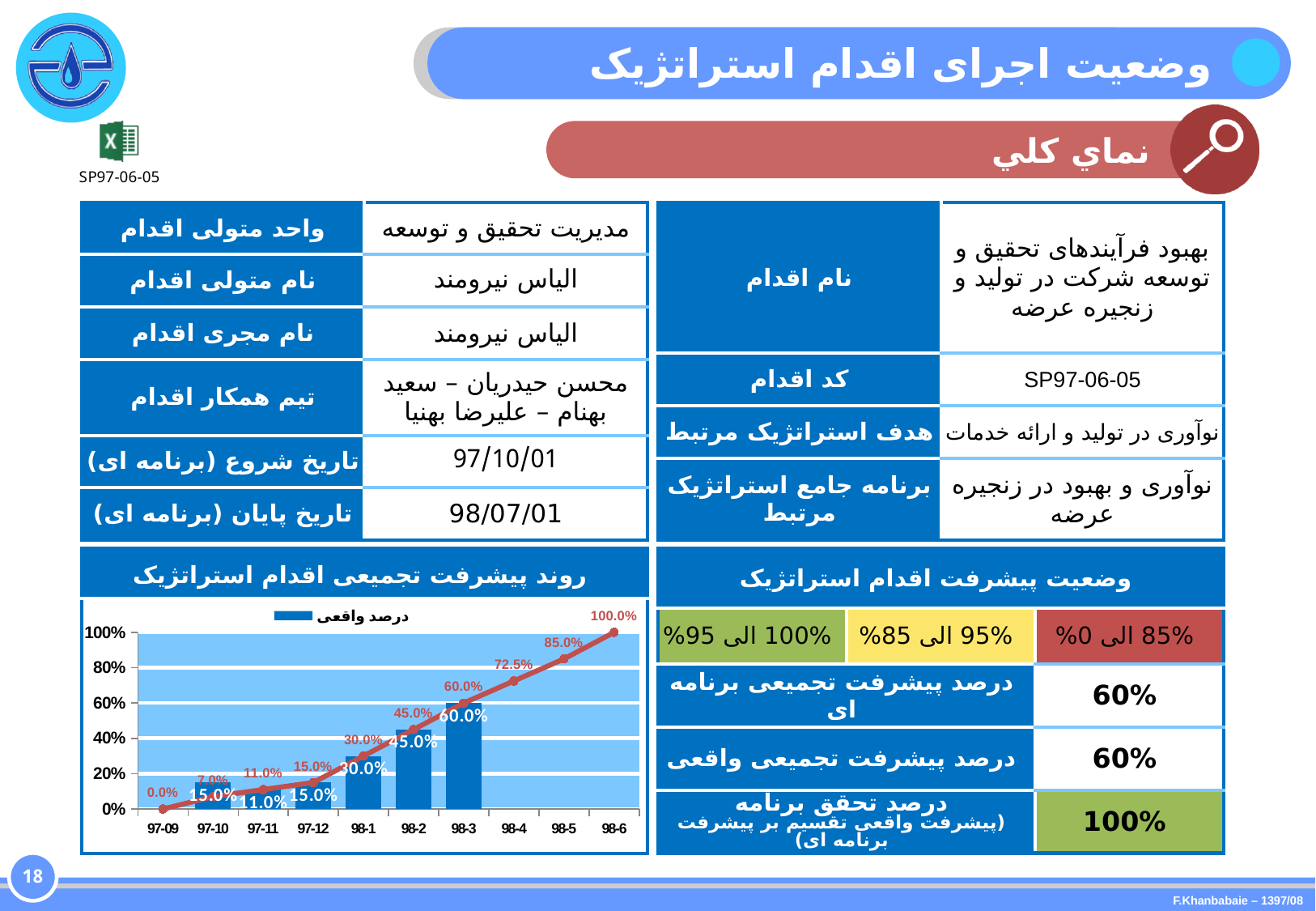
What is the difference between the line values for 98-5 and 98-4 in the progress chart? 12.5% What is the line value for 98-6 in the progress chart? 100.0% Which category has the highest line value in the progress chart? 98-6 What is the bar value (درصد واقعی) for 98-3 in the progress chart? 60.0% What is the line value for 97-10 in the progress chart? 7.0% What kind of chart is shown under the title 'روند پیشرفت تجمیعی اقدام استراتژیک'? Combined bar and line chart How many categories are shown on the x axis of the progress chart? 10 Which category has the lowest line value in the progress chart? 97-09 What is the line value for 98-4 in the progress chart? 72.5% What is the bar value (درصد واقعی) for 98-1 in the progress chart? 30.0% Is the line value for 98-5 greater or less than the line value for 98-3 in the progress chart? greater Do the line values rise or fall from 97-09 to 98-6 in the progress chart? rise